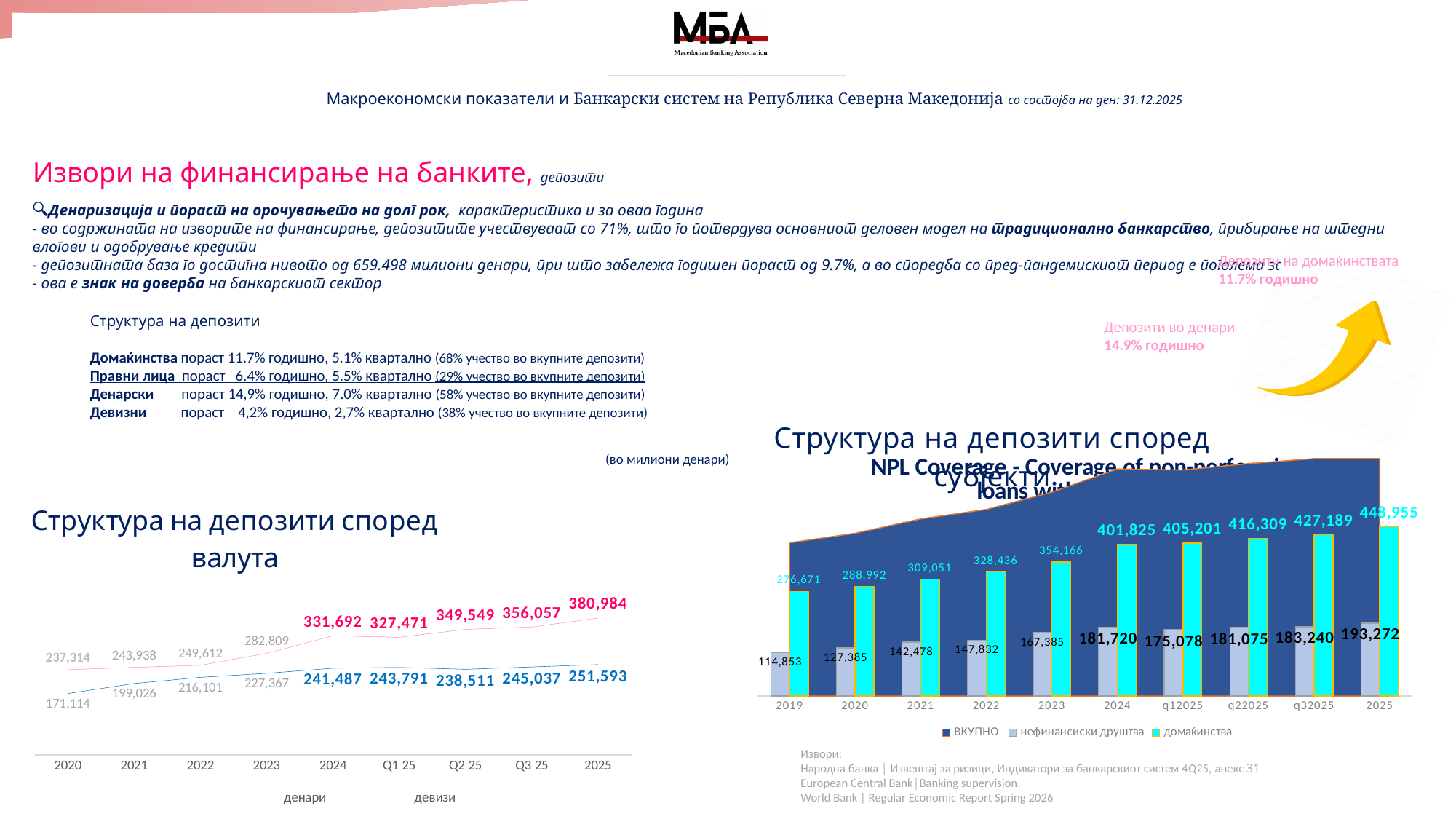
How many series does the legend of the right chart 'Структура на депозити според субјекти' list? 3 What kind of chart is the left chart titled 'Структура на депозити според валута'? line chart In the left chart 'Структура на депозити според валута', does the upper (pink) line generally rise or fall from 2020 to 2025? rise In the right chart 'Структура на депозити според субјекти', what is the value for нефинансиски друштва in 2019? 114,853 How many series does the legend of the left chart 'Структура на депозити според валута' list? 2 In the right chart 'Структура на депозити според субјекти', what is the difference between домаќинства and нефинансиски друштва in 2024? 220,105 In the left chart 'Структура на депозити според валута', what is the difference between the upper (pink) line and the lower (blue) line in 2025? 129,391 How many periods are shown on the x axis of the left chart 'Структура на депозити според валута'? 9 In the left chart 'Структура на депозити според валута', what is the value of the lower (blue) line for 2020? 171,114 In the right chart 'Структура на депозити според субјекти', which period has the highest value for домаќинства? 2025 In the right chart 'Структура на депозити според субјекти', what is the value for домаќинства in 2025? 448,955 In the left chart 'Структура на депозити според валута', what is the value of the upper (pink) line for 2025? 380,984